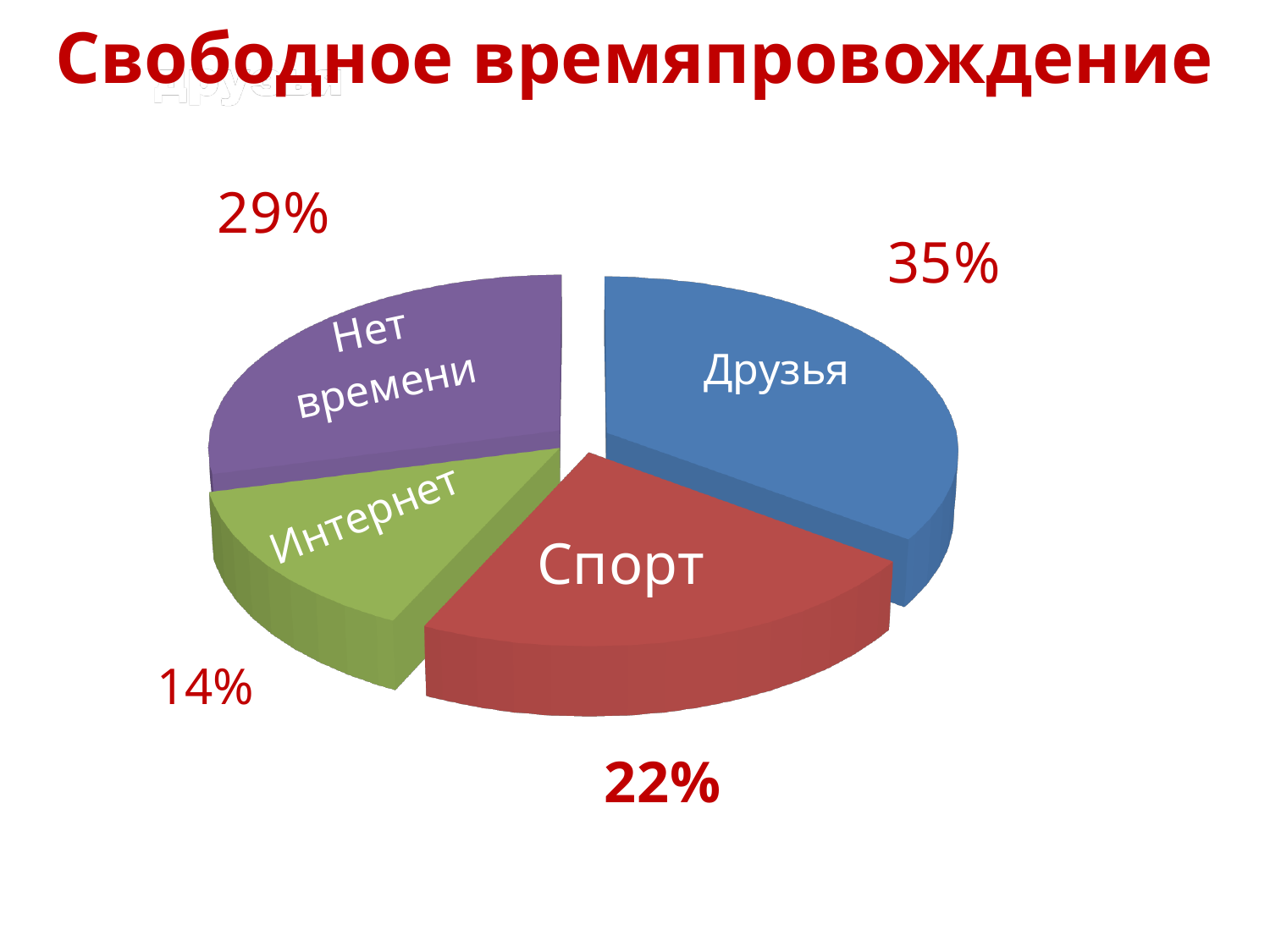
Which category has the smallest slice of the pie? Интернет How many slices does the pie chart have? 4 What share of the pie does the Нет времени slice represent? 29% What is the title of the slide? Свободное времяпровождение What is the difference in percentage points between Друзья and Спорт? 13% Which is larger, the share for Нет времени or the share for Спорт? Нет времени What is the difference in percentage points between Нет времени and Интернет? 15% What share of the pie does the Друзья slice represent? 35% What kind of chart is shown on the slide? Pie chart Which category has the largest slice of the pie? Друзья What share of the pie does the Спорт slice represent? 22%